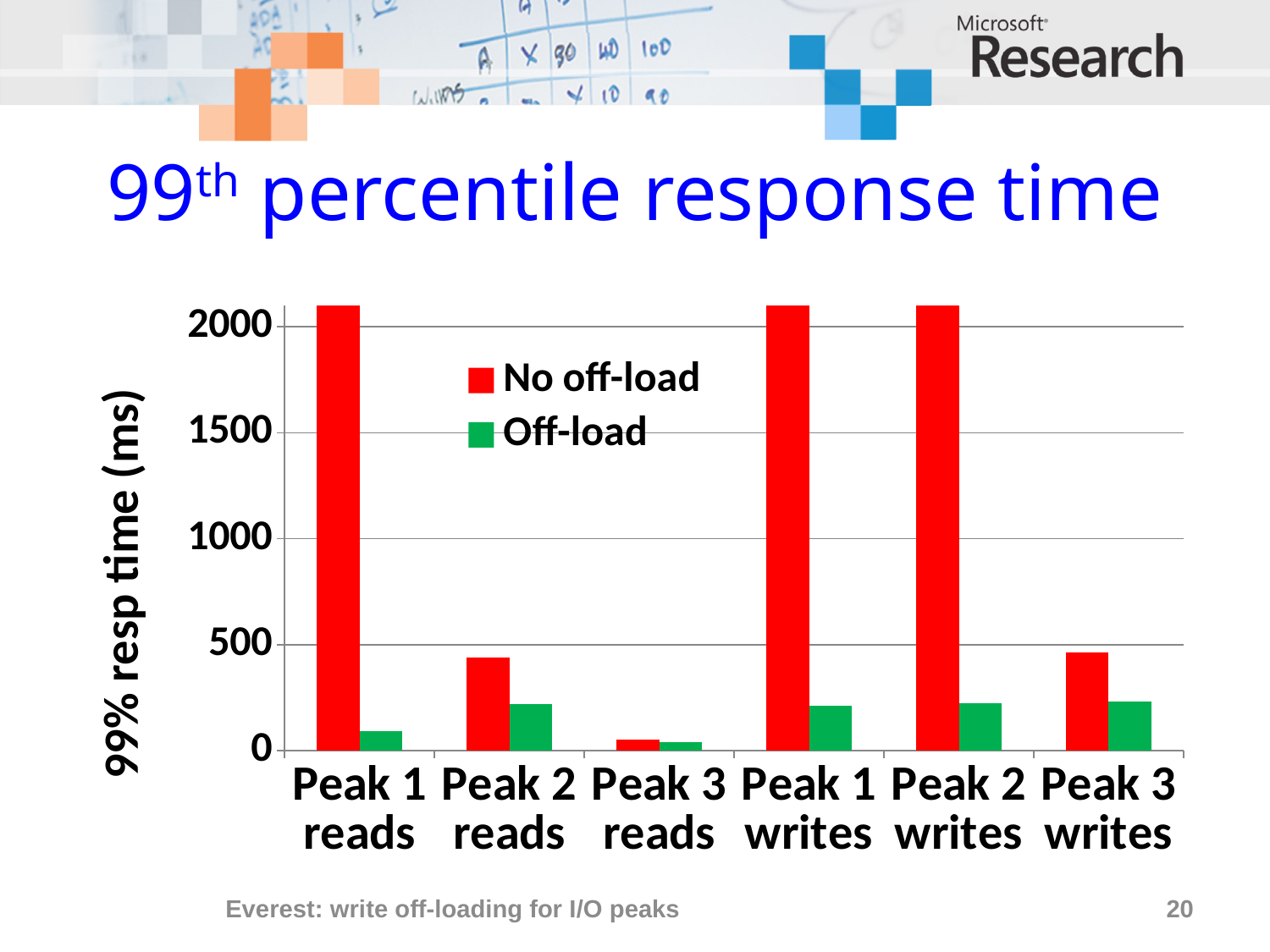
Which category has the lowest No off-load value? Peak 3 reads For Peak 3 writes, which series has the larger value, No off-load or Off-load? No off-load What is the label of the y axis? 99% resp time (ms) Is the No off-load value for Peak 2 reads greater or less than 500? less Is the No off-load value for Peak 2 writes greater or less than 1500? greater Is the Off-load value for Peak 1 writes greater or less than 500? less How many categories are shown along the x axis? 6 Which colour represents the Off-load series in the legend? green What kind of chart is shown on the slide? bar chart How many series does the legend list? 2 Which is larger: the No off-load value for Peak 2 reads or the No off-load value for Peak 3 reads? Peak 2 reads